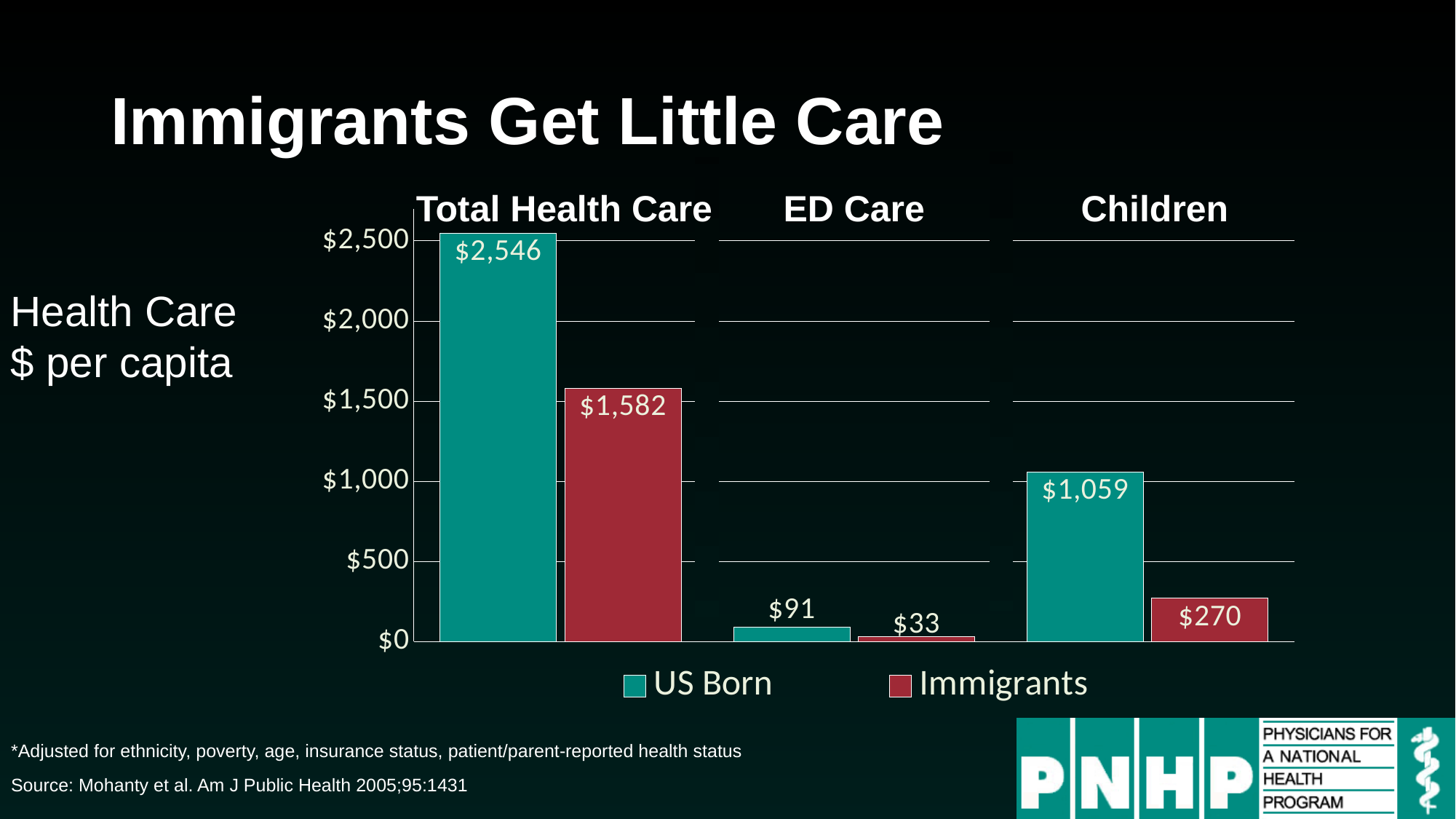
Which is larger, the ED Care value for US Born or for Immigrants? US Born What is the Total Health Care value for US Born? $2,546 What is the difference between the US Born and Immigrants values for Children? $789 What is the ED Care value for Immigrants? $33 What colour are the Immigrants bars? Red What is the Total Health Care value for Immigrants? $1,582 Which category has the highest value for US Born? Total Health Care What is the difference between the US Born and Immigrants values for Total Health Care? $964 Which category has the lowest value for Immigrants? ED Care How many series does the legend list? 2 What kind of chart is shown on the slide? Bar chart What is the Children value for US Born? $1,059